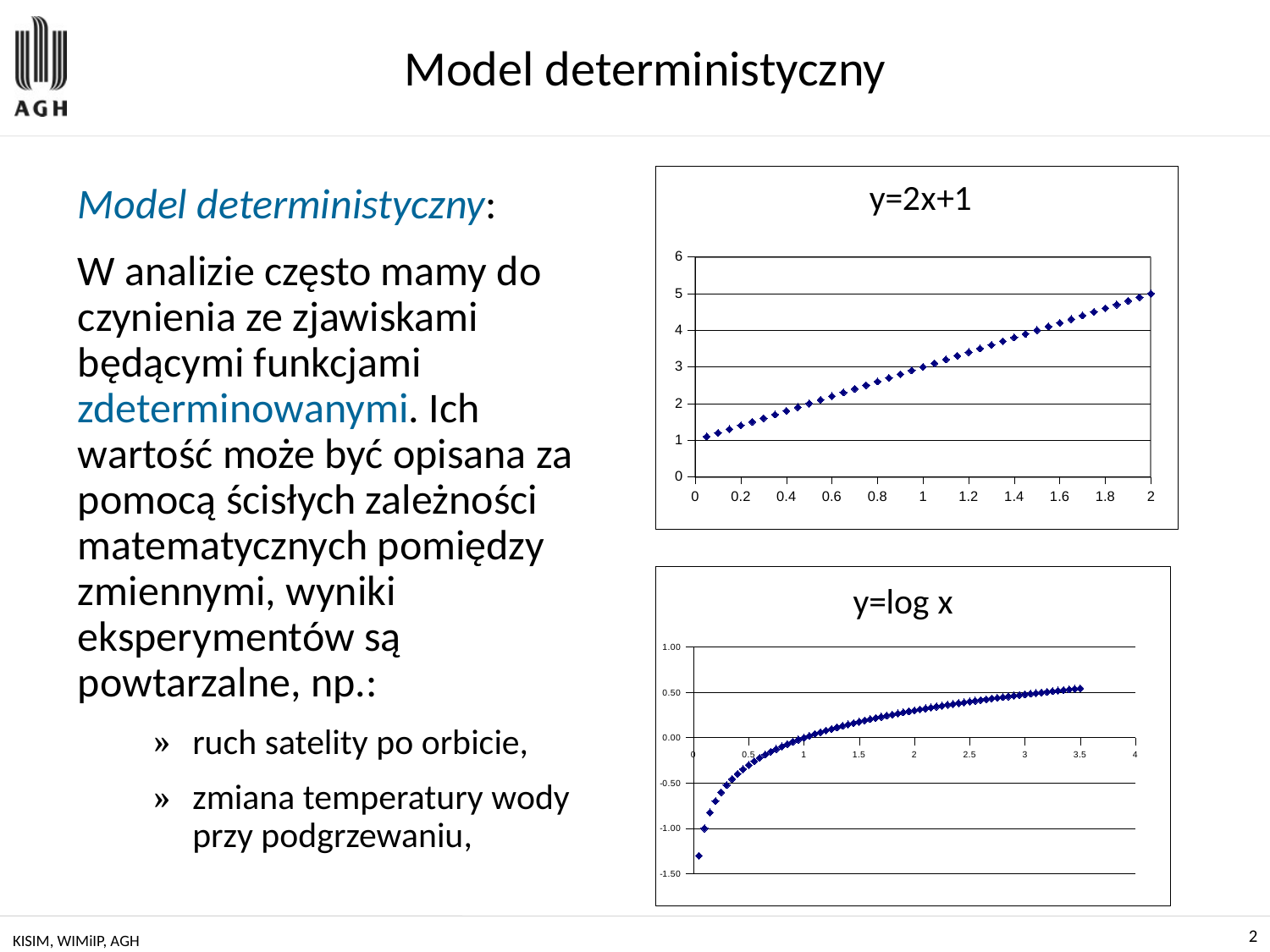
What is the title of the upper chart on the slide? y=2x+1 In the chart titled y=log x, is the value at x = 2 greater or less than 0.00? greater In the chart titled y=log x, what is the y value of the point at x = 1? 0.00 What kind of chart is the chart titled y=2x+1? scatter chart In the chart titled y=2x+1, do the values rise or fall as x increases? rise In the chart titled y=2x+1, what is the y value of the point at x = 2? 5 In the chart titled y=log x, do the values rise or fall as x increases? rise In the chart titled y=log x, is the lowest plotted value greater or less than -1.00? less In the chart titled y=2x+1, what is the y value of the point at x = 1? 3 In the chart titled y=2x+1, what is the y value of the point at x = 0.5? 2 What kind of chart is the chart titled y=log x? scatter chart In the chart titled y=log x, is the value at x = 0.5 greater or less than 0.00? less